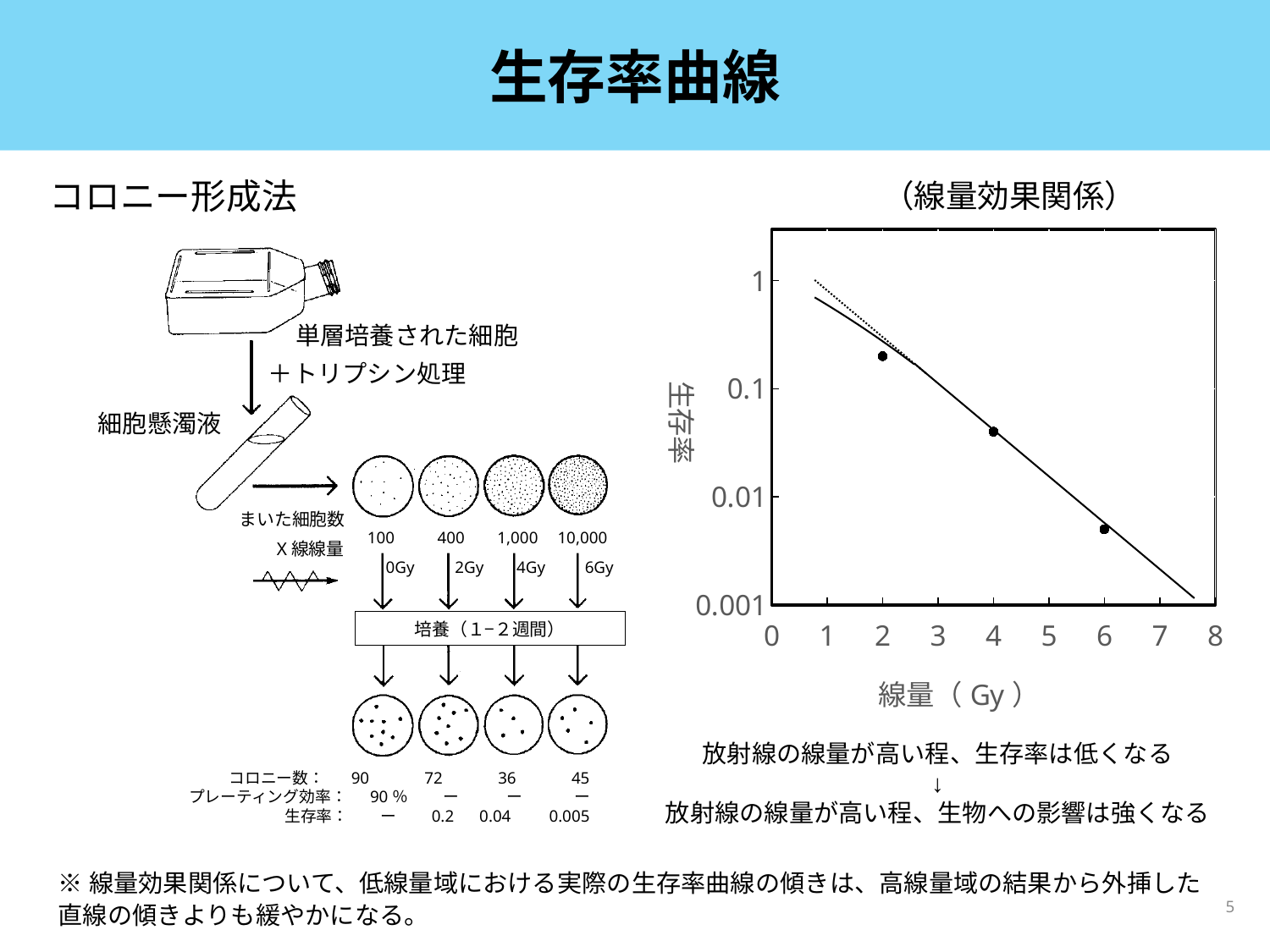
On the survival curve chart, which has the larger survival rate: the point at 2 Gy or the point at 6 Gy? 2 Gy What is the label of the x axis of the survival curve chart? 線量（Gy） On the survival curve chart, is the survival rate at 6 Gy greater or less than 0.01? less What is the label of the y axis of the survival curve chart? 生存率 According to the slide, what is the survival rate (生存率) at 4 Gy? 0.04 On the survival curve chart, does the survival rate rise or fall as the dose increases? fall On the survival curve chart, is the survival rate at 4 Gy greater or less than 0.1? less How many data points are plotted on the survival curve chart? 3 On the survival curve chart, at which dose is the plotted survival rate lowest? 6 Gy On the survival curve chart, at which dose is the plotted survival rate highest? 2 Gy What kind of chart is shown on the right side of the slide? line chart On the survival curve chart, is the survival rate at 2 Gy greater or less than 0.1? greater